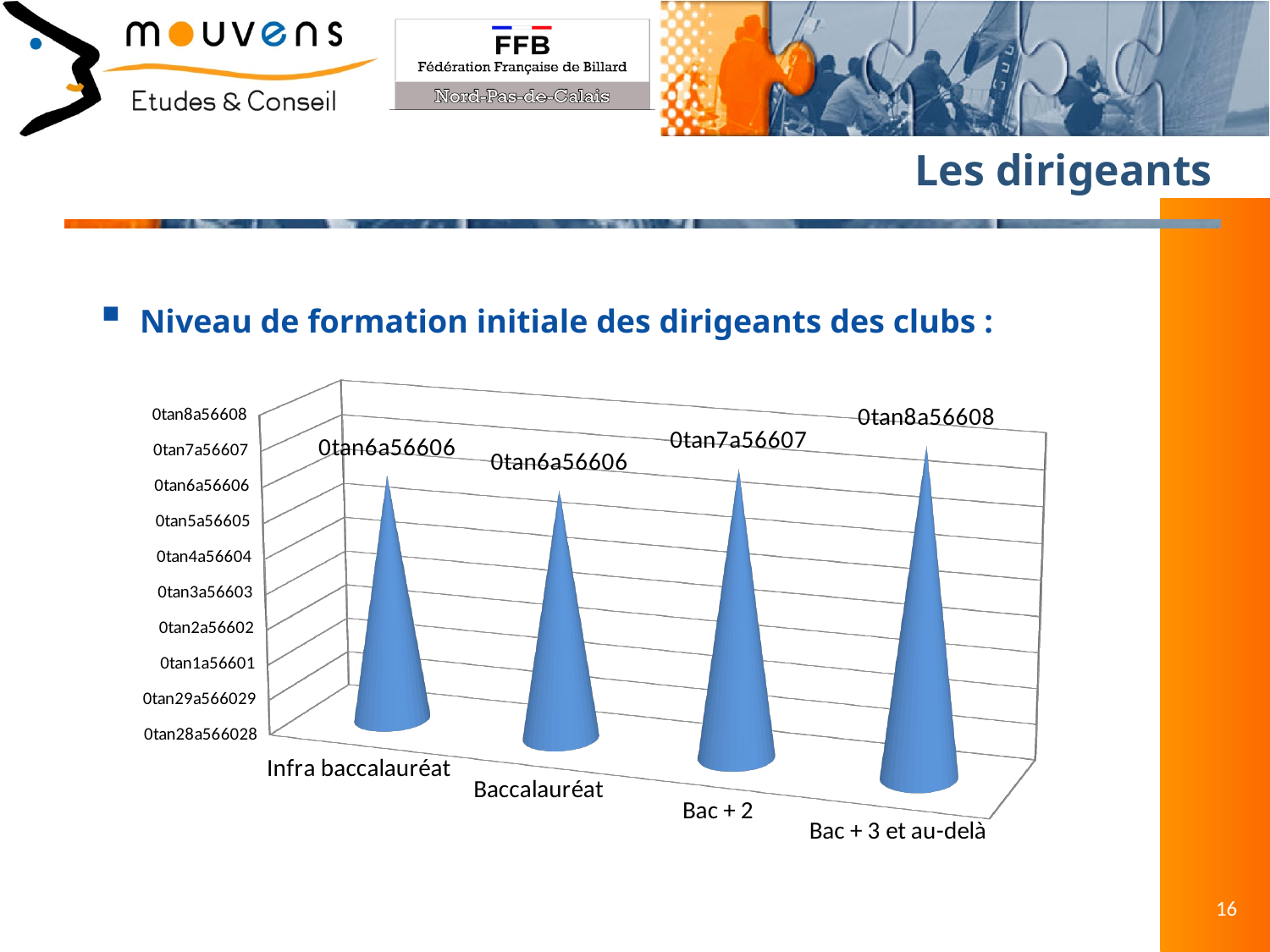
What is the data label printed above the Bac + 3 et au-delà bar? 0tan8a56608 Which is larger, the value for Bac + 2 or the value for Baccalauréat? Bac + 2 What is the label of the first category on the x axis? Infra baccalauréat What kind of chart is shown on the slide? bar chart Which category has the highest value in the chart? Bac + 3 et au-delà What is the data label printed above the Bac + 2 bar? 0tan7a56607 Which is larger, the value for Bac + 3 et au-delà or the value for Infra baccalauréat? Bac + 3 et au-delà What colour are the bars in the chart? blue How many categories are shown on the x axis of the chart? 4 Do the values generally rise or fall from Infra baccalauréat to Bac + 3 et au-delà? rise